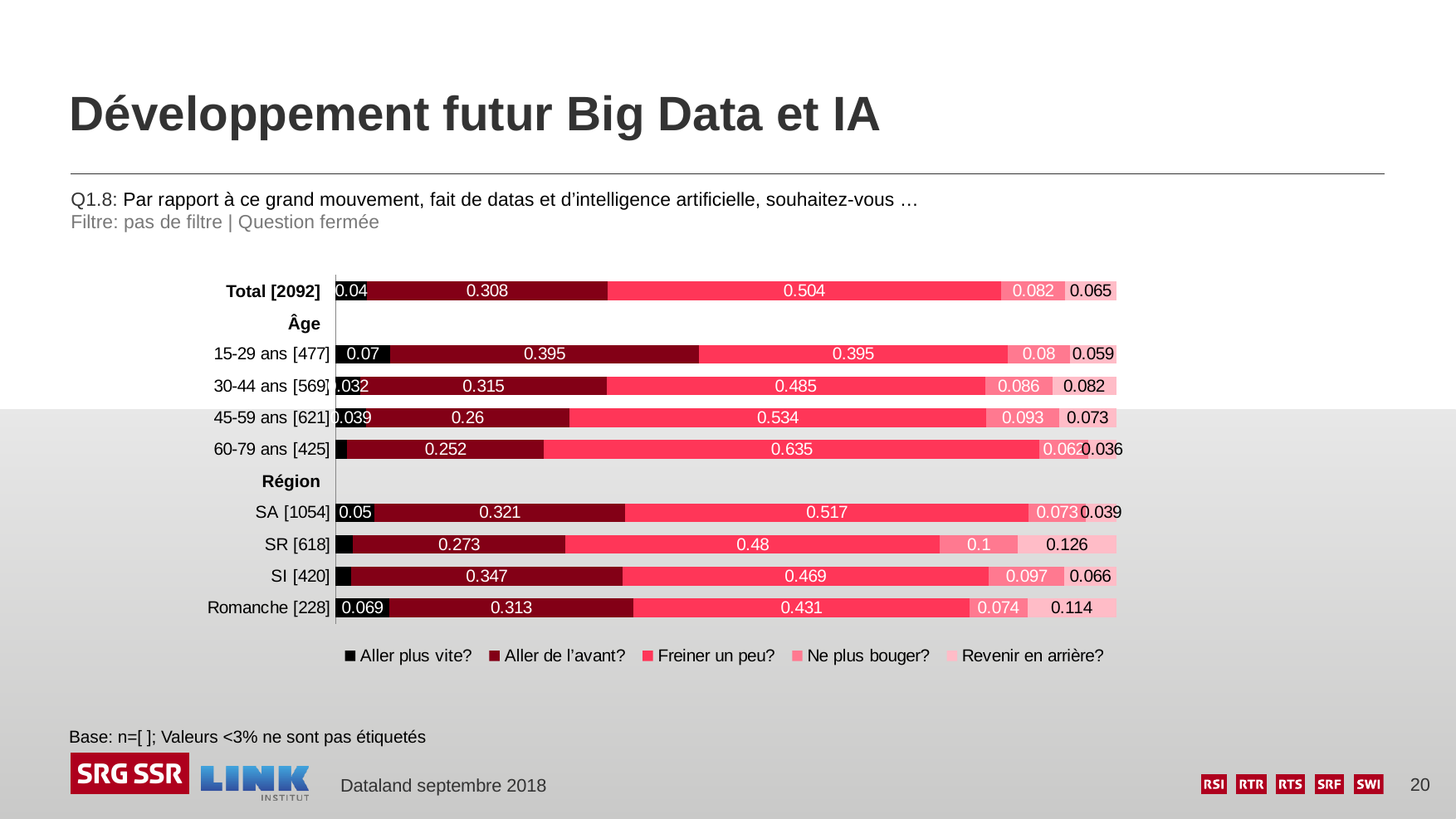
Which category has the highest value for "Aller de l’avant?"? 15-29 ans [477] In the Total [2092] bar, what is the difference between "Freiner un peu?" and "Aller de l’avant?"? 0.196 Which category has the highest value for "Freiner un peu?"? 60-79 ans [425] Which has the larger value for "Freiner un peu?": SA [1054] or SR [618]? SA [1054] Which category has the lowest value for "Freiner un peu?"? 15-29 ans [477] How many series does the legend list? 5 What is the value for "Aller de l’avant?" for 15-29 ans [477]? 0.395 What is the value for "Freiner un peu?" in the Total [2092] bar? 0.504 What kind of chart is shown on the slide? Stacked bar chart What is the value for "Ne plus bouger?" for 45-59 ans [621]? 0.093 What is the value for "Revenir en arrière?" for SR [618]? 0.126 How many bars (categories) are plotted in the chart? 9